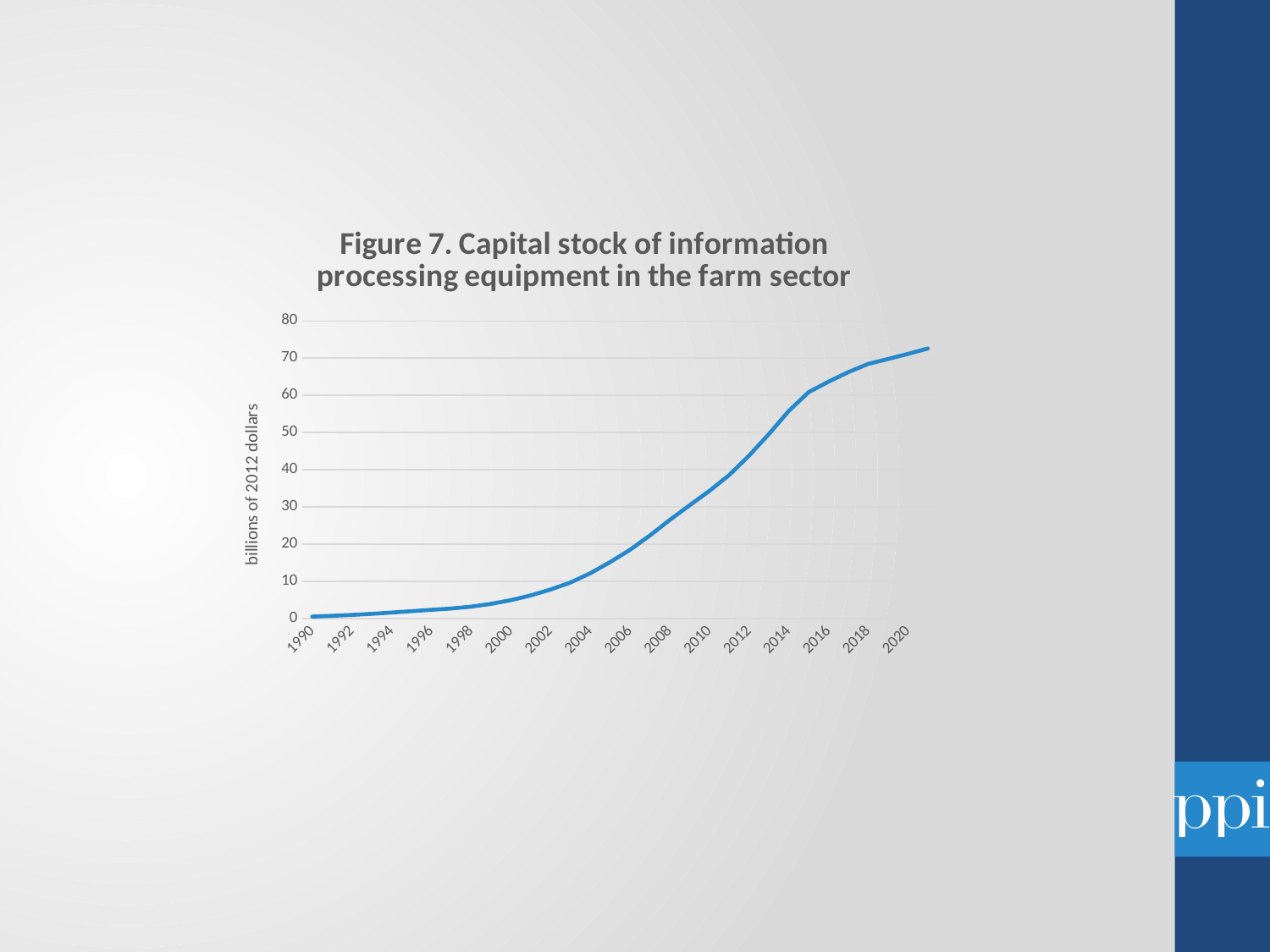
Which is larger, the value for 2000 or the value for 2010? 2010 Is the value for 2006 greater or less than 20? less Do the values rise or fall from 1990 to 2020? rise What kind of chart is shown on the slide? line chart What is the label on the vertical axis of the chart? billions of 2012 dollars Is the value for 2010 greater or less than 20? greater Is the value for 2014 greater or less than 40? greater Which year has the lowest value on the chart? 1990 What is the title of the chart? Figure 7. Capital stock of information processing equipment in the farm sector